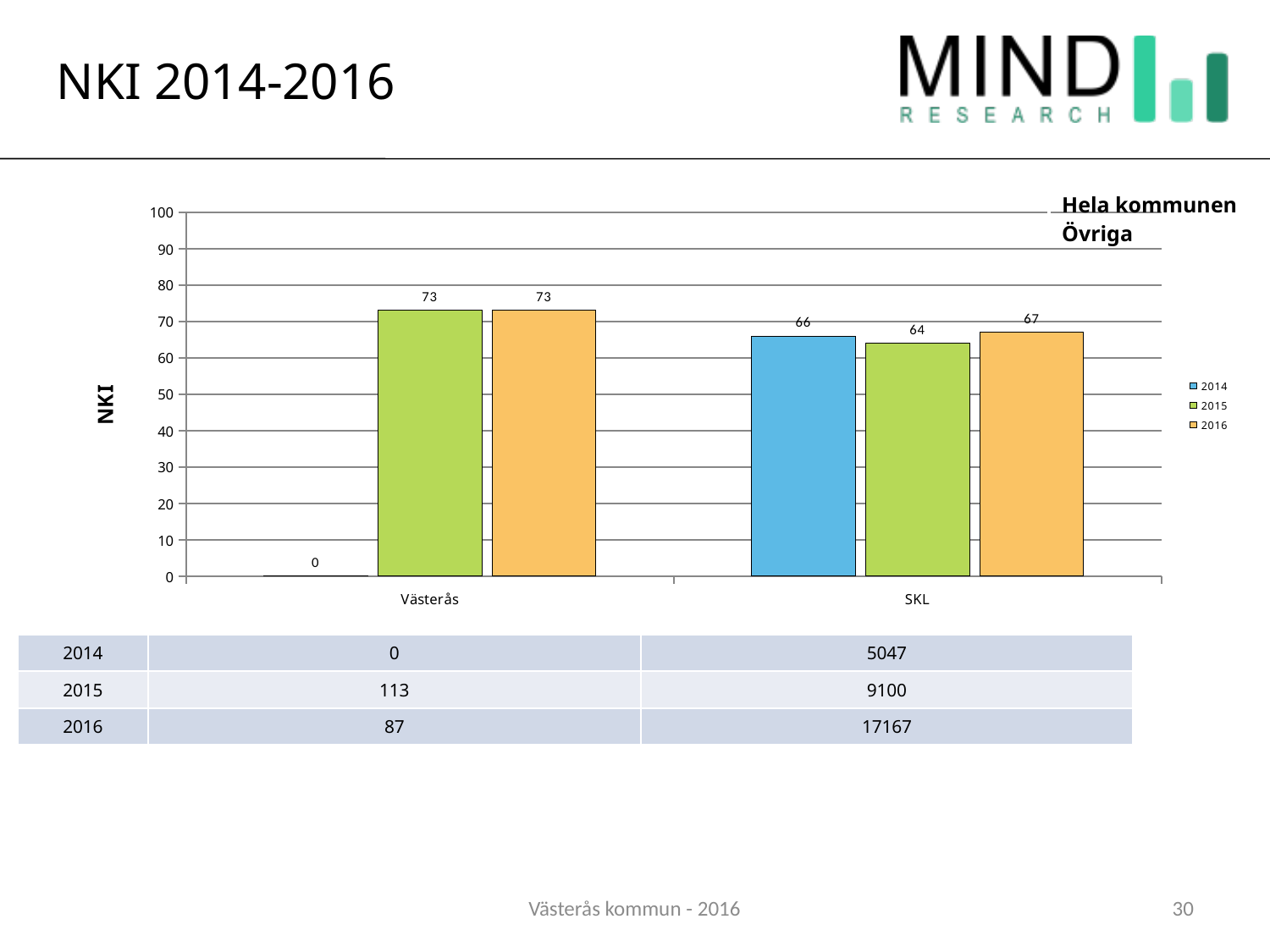
Which year has the highest NKI value for SKL? 2016 How many categories are shown on the x axis of the chart? 2 Which is larger, the 2015 NKI value for Västerås or for SKL? Västerås What is the label of the vertical axis of the chart? NKI What is the NKI value for SKL in 2014? 66 What is the difference between the 2016 NKI values for Västerås and SKL? 6 How many series does the chart legend list? 3 What kind of chart is shown on the slide? Bar chart What is the NKI value for Västerås in 2014? 0 Which year has the lowest NKI value for SKL? 2015 What is the NKI value for SKL in 2015? 64 What is the NKI value for Västerås in 2015? 73